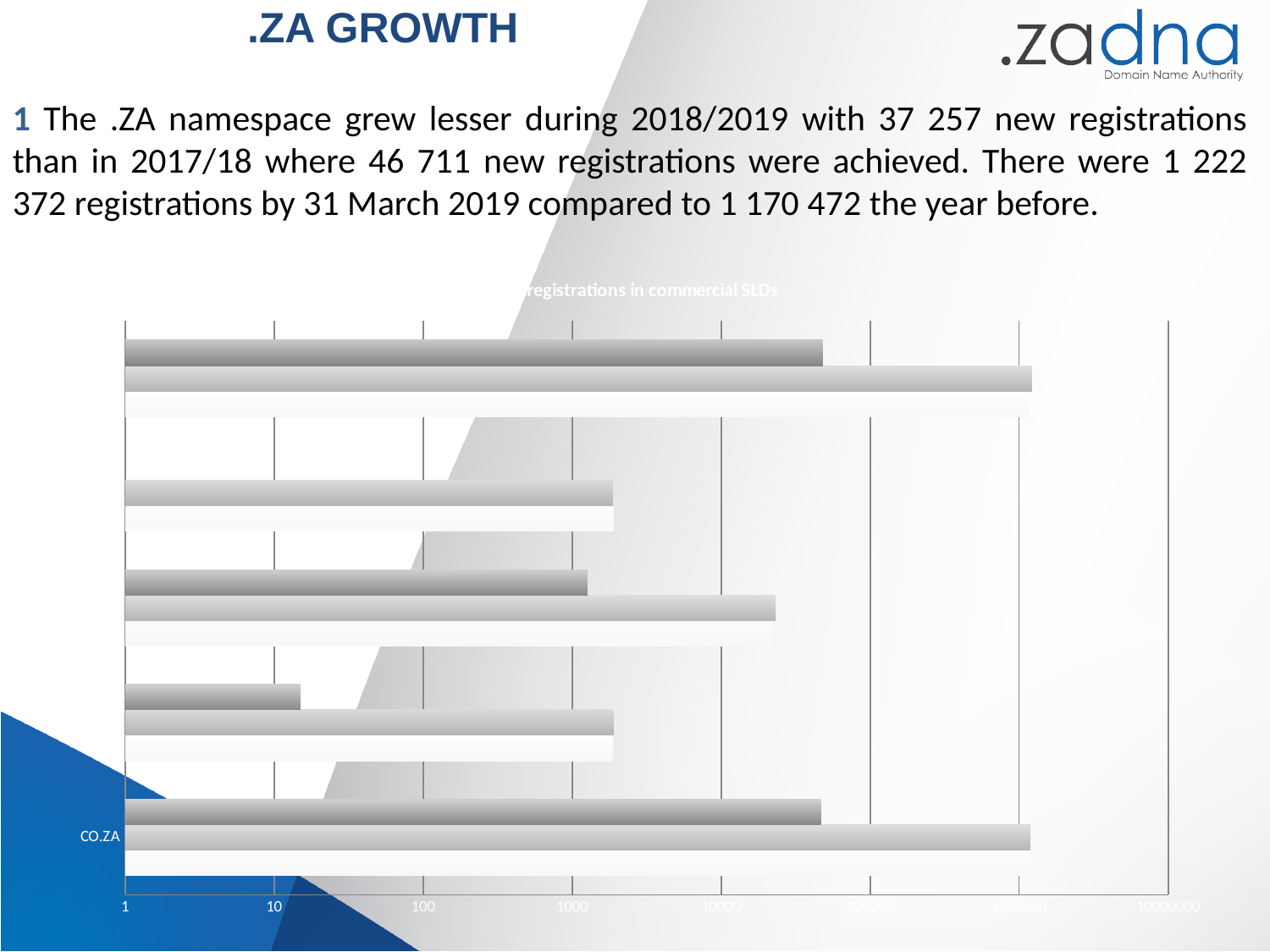
How many bars are plotted for CO.ZA? 2 Is the shortest bar on the chart greater or less than 100? less What kind of chart is shown on the slide? bar chart Is the shorter bar for CO.ZA greater or less than 10000? greater Which category label is readable at the bottom of the chart's vertical axis? CO.ZA For CO.ZA, which bar is longer, the upper bar or the lower bar? lower bar Is the shorter bar for CO.ZA greater or less than 100000? less What is the largest value shown on the chart's horizontal axis? 10000000